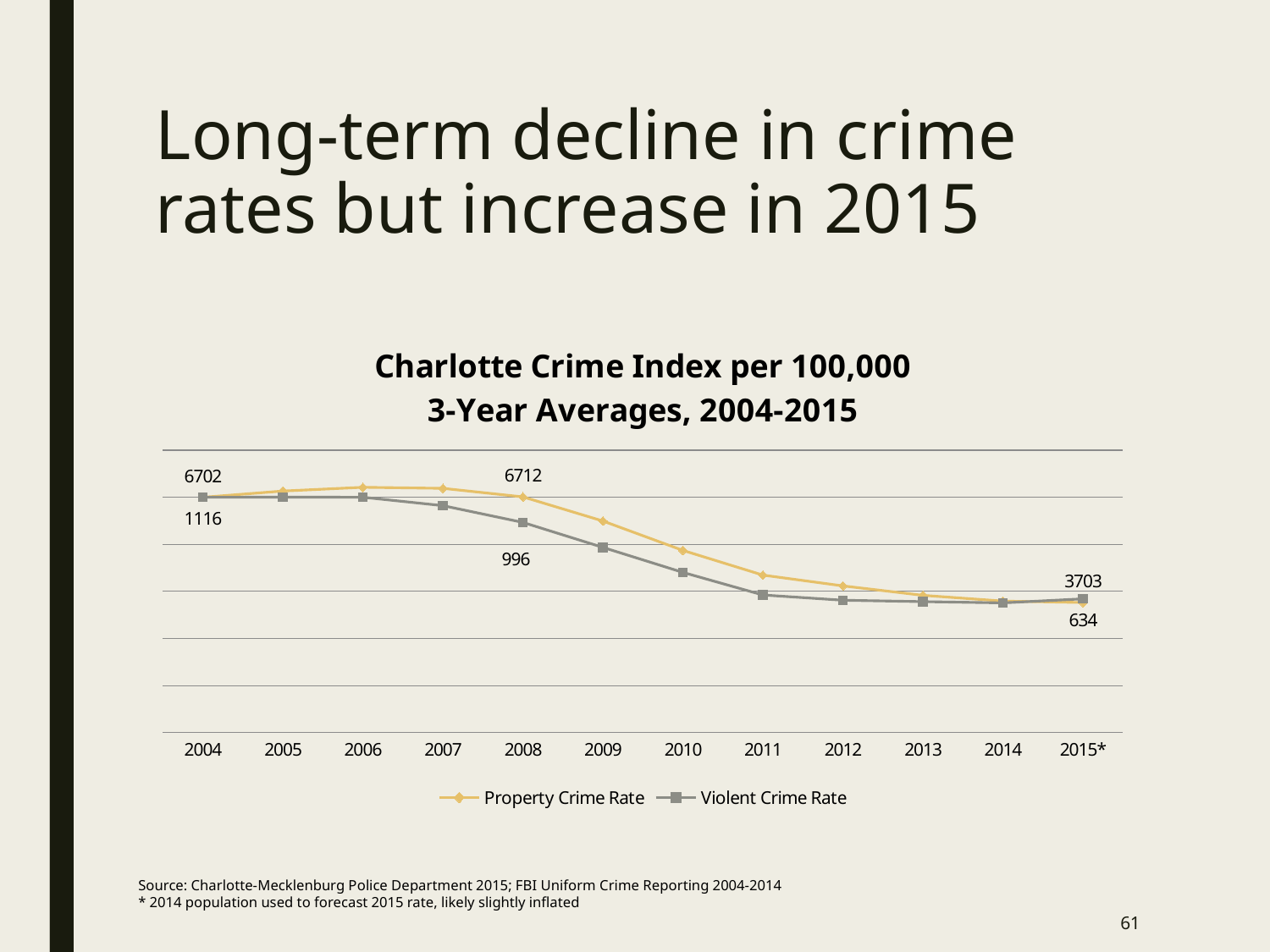
What kind of chart is shown on the slide? Line chart What is the Violent Crime Rate value labeled for 2004? 1116 How many years are shown on the x axis of the chart? 12 How many series does the legend list? 2 What is the difference between the labeled Violent Crime Rate in 2004 and in 2015*? 482 Which year has the higher labeled Property Crime Rate, 2004 or 2008? 2008 What is the Violent Crime Rate value labeled for 2015*? 634 What is the Property Crime Rate value labeled for 2015*? 3703 What is the Violent Crime Rate value labeled for 2008? 996 What is the Property Crime Rate value labeled for 2004? 6702 By how much did the labeled Property Crime Rate fall from 2004 to 2015*? 2999 What is the Property Crime Rate value labeled for 2008? 6712